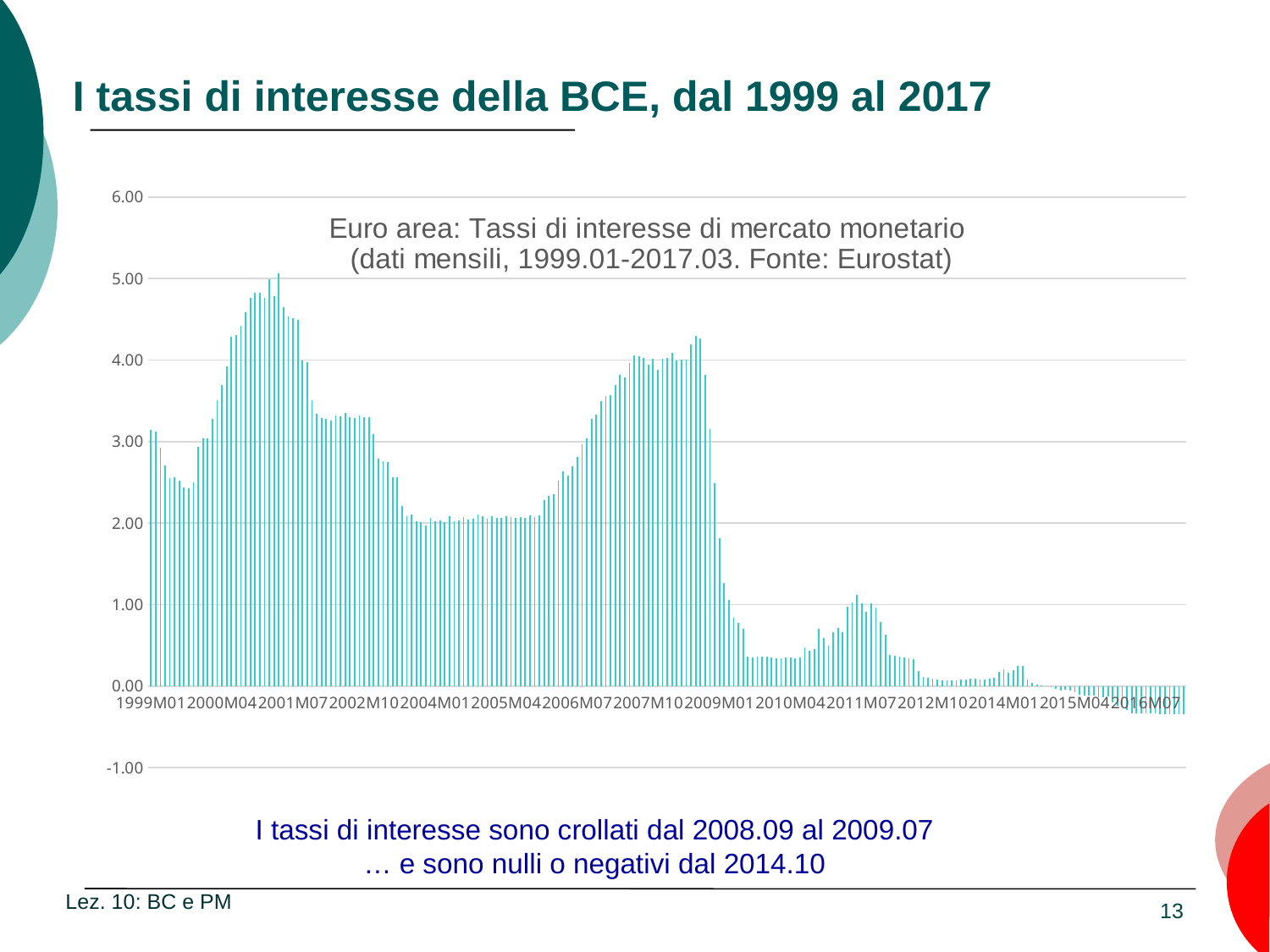
Which is larger, the value for 2007M10 or the value for 2014M01? 2007M10 Is the value for 2004M01 greater or less than 3.00? less What is the source of the data cited in the chart title? Eurostat Is the value for 2010M04 greater or less than 1.00? less Do the values rise or fall between 2007M10 and 2009M01? fall Is the value for 2000M04 greater or less than 3.00? greater Do the values rise or fall between 2005M04 and 2007M10? rise What is the title of the chart? Euro area: Tassi di interesse di mercato monetario (dati mensili, 1999.01-2017.03. Fonte: Eurostat) What kind of chart is shown on the slide? bar chart Which is larger, the value for 2000M04 or the value for 2010M04? 2000M04